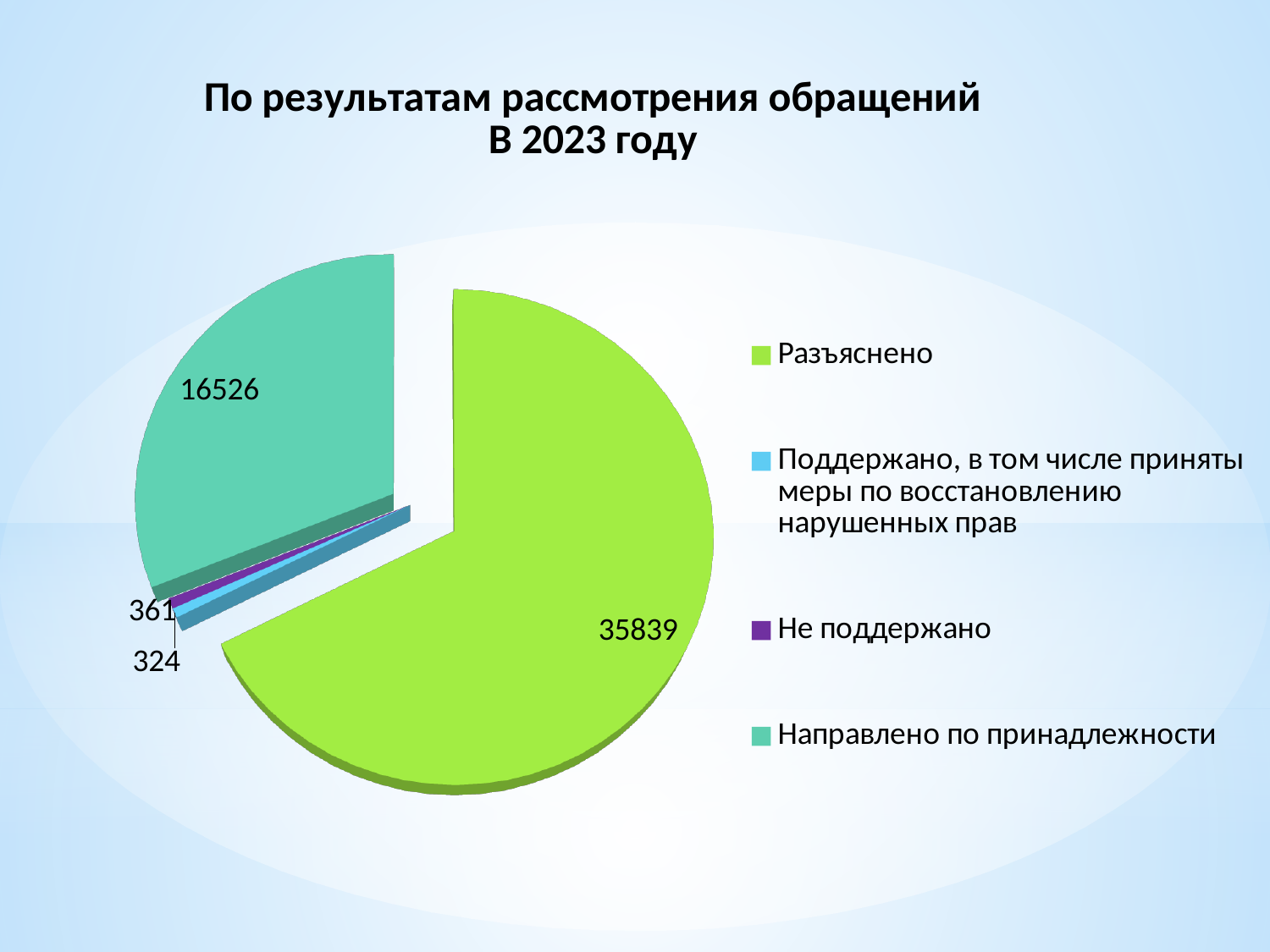
What is the value for Разъяснено? 35839 Which is larger, the value for Разъяснено or the value for Направлено по принадлежности? Разъяснено What is the title of the chart? По результатам рассмотрения обращений В 2023 году What colour is the slice for Разъяснено? green What is the smallest value labelled on the pie chart? 324 How many slices does the pie chart have? 4 What is the value for Направлено по принадлежности? 16526 What kind of chart is shown on the slide? pie chart Which category has the largest slice of the pie? Разъяснено What is the total of all four values shown on the pie chart? 53050 How many entries does the legend list? 4 What is the difference between the values for Разъяснено and Направлено по принадлежности? 19313